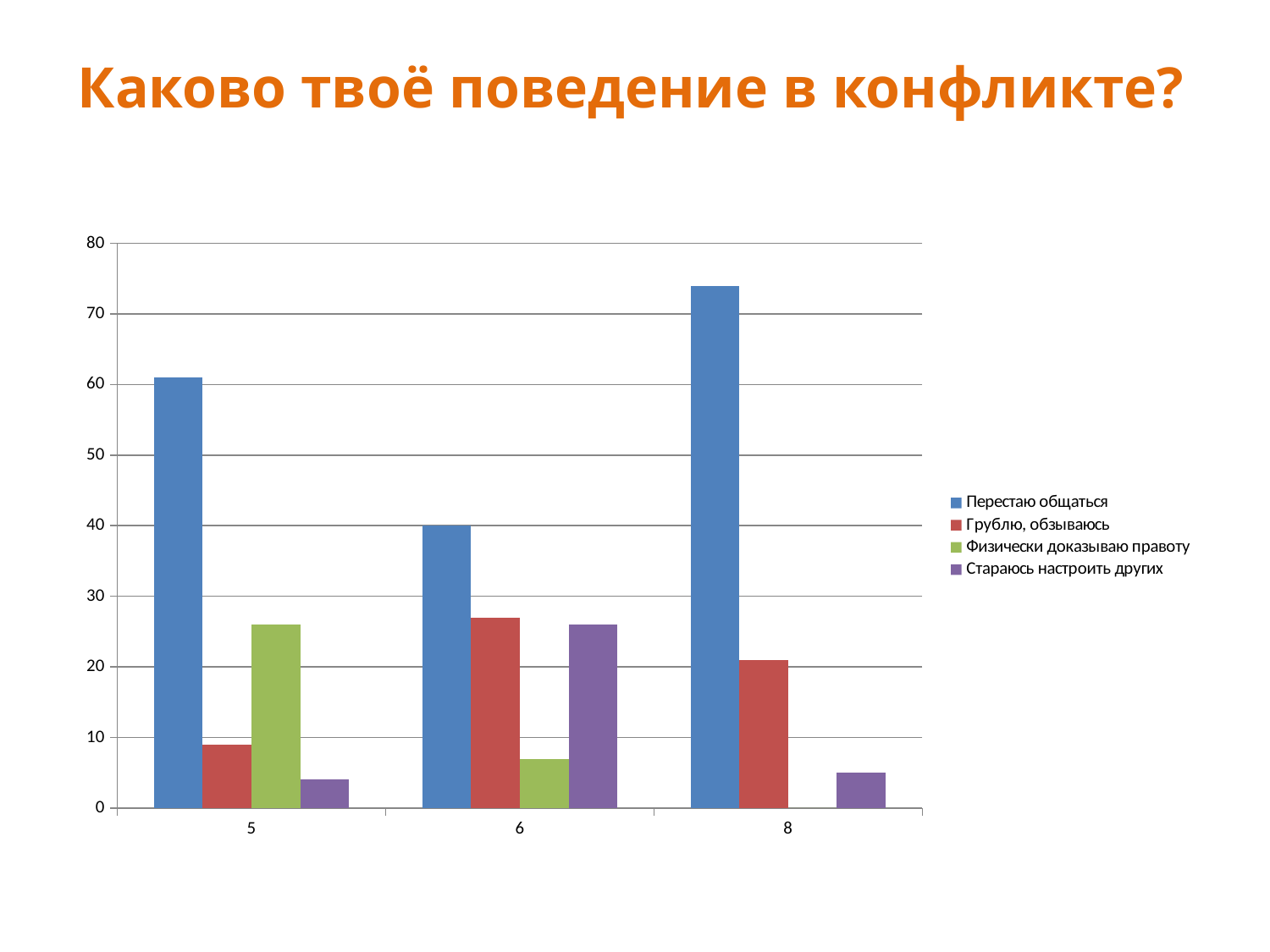
In which category is the value for "Перестаю общаться" highest? 8 What kind of chart is shown on the slide? bar chart Is the value for "Перестаю общаться" in category 8 greater or less than 70? greater In which category is the value for "Перестаю общаться" lowest? 6 How many categories are shown on the x axis? 3 How many series does the legend list? 4 What is the value for "Перестаю общаться" in category 6? 40 Which is larger in category 6: "Грублю, обзываюсь" or "Физически доказываю правоту"? Грублю, обзываюсь Is the value for "Физически доказываю правоту" in category 5 greater or less than 20? greater What is the title of the slide? Каково твоё поведение в конфликте?